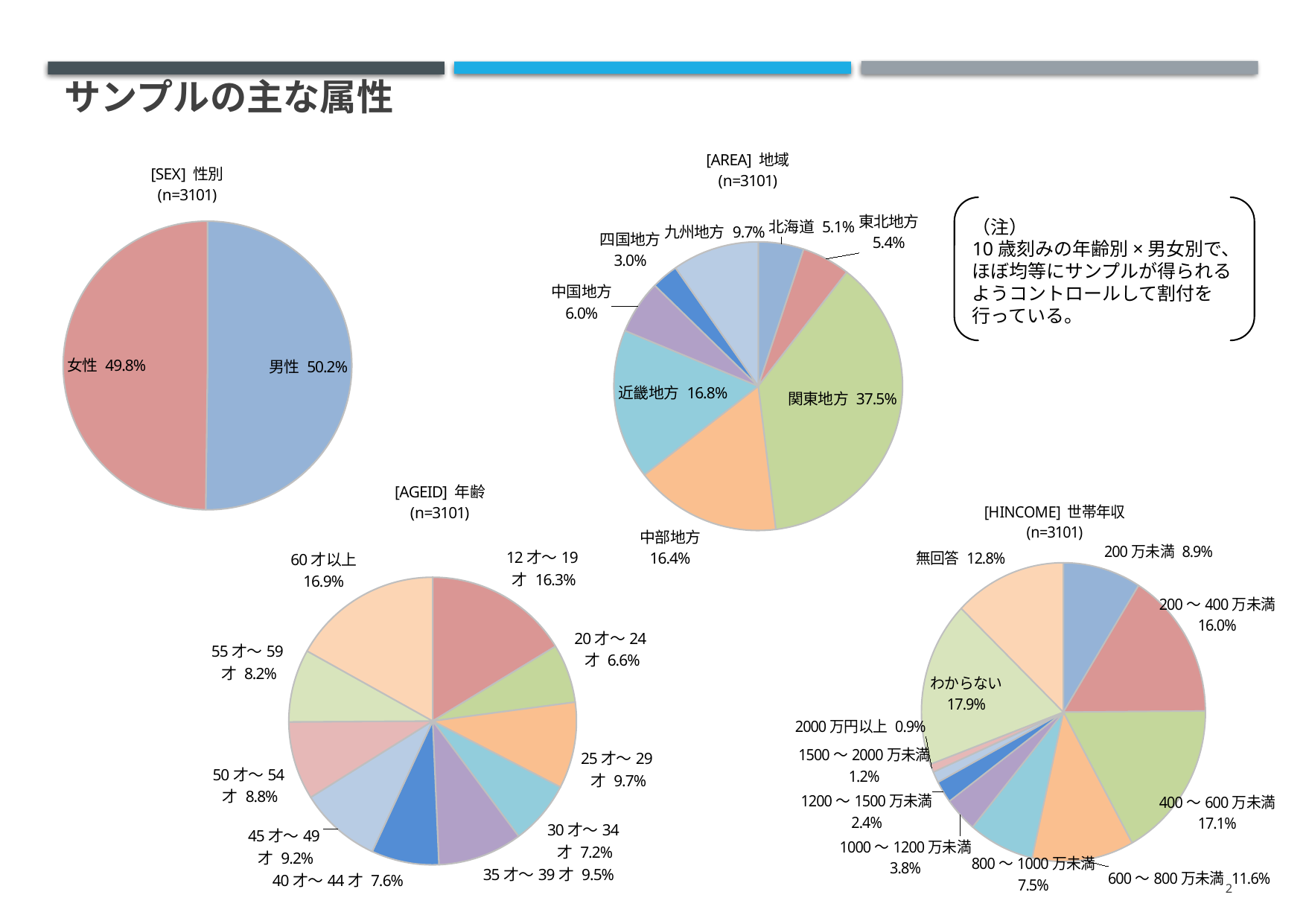
In the [AGEID] 年齢 chart, which age group has the largest share? 60才以上 In the [HINCOME] 世帯年収 chart, which is larger, わからない or 無回答? わからない In the [AREA] 地域 chart, how many regions are shown? 8 In the [AREA] 地域 chart, what is the value for 近畿地方? 16.8% In the [SEX] 性別 chart, what share is 男性? 50.2% In the [AGEID] 年齢 chart, what is the difference between 12才～19才 and 20才～24才? 9.7% In the [AGEID] 年齢 chart, what is the value for 45才～49才? 9.2% In the [HINCOME] 世帯年収 chart, which category has the smallest share? 2000万円以上 In the [AREA] 地域 chart, which region has the largest share? 関東地方 In the [HINCOME] 世帯年収 chart, what is the value for 400～600万未満? 17.1% In the [AREA] 地域 chart, which region has the smallest share? 四国地方 What kind of chart is the [SEX] 性別 chart? pie chart